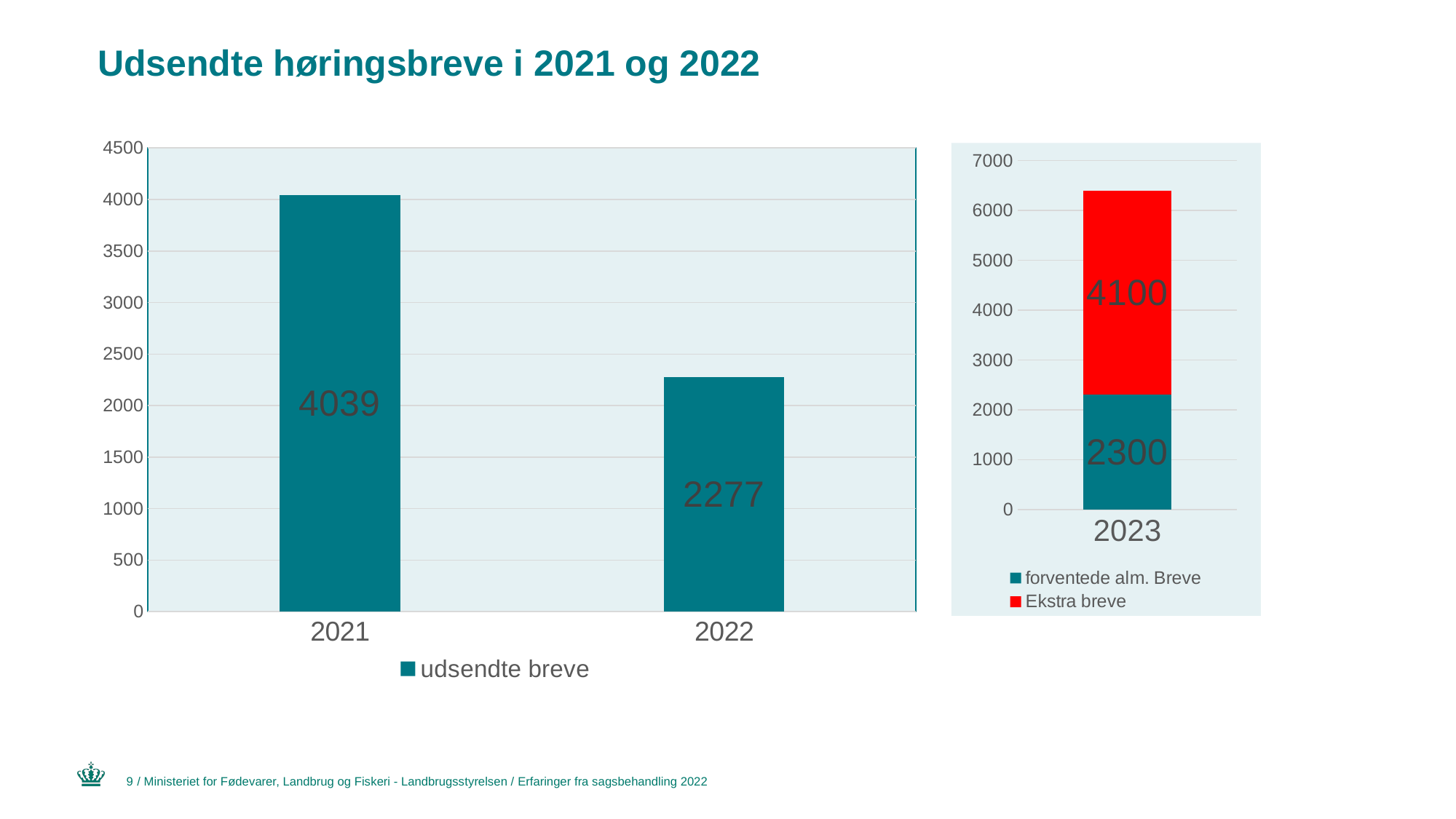
In the left chart, how many bars are plotted? 2 In the right chart, what is the value for 'Ekstra breve' in 2023? 4100 In the left chart, what is the value for 2021? 4039 In the left chart, which year has the higher value? 2021 In the left chart, do the values rise or fall from 2021 to 2022? fall In the right chart, how many series does the legend list? 2 In the left chart, what series name does the legend show? udsendte breve In the right chart, what is the total of the stacked bar for 2023? 6400 What kind of chart is the right chart? stacked bar chart In the left chart, what is the difference between the 2021 and 2022 values? 1762 In the left chart, what is the value for 2022? 2277 In the right chart, what is the value for 'forventede alm. Breve' in 2023? 2300